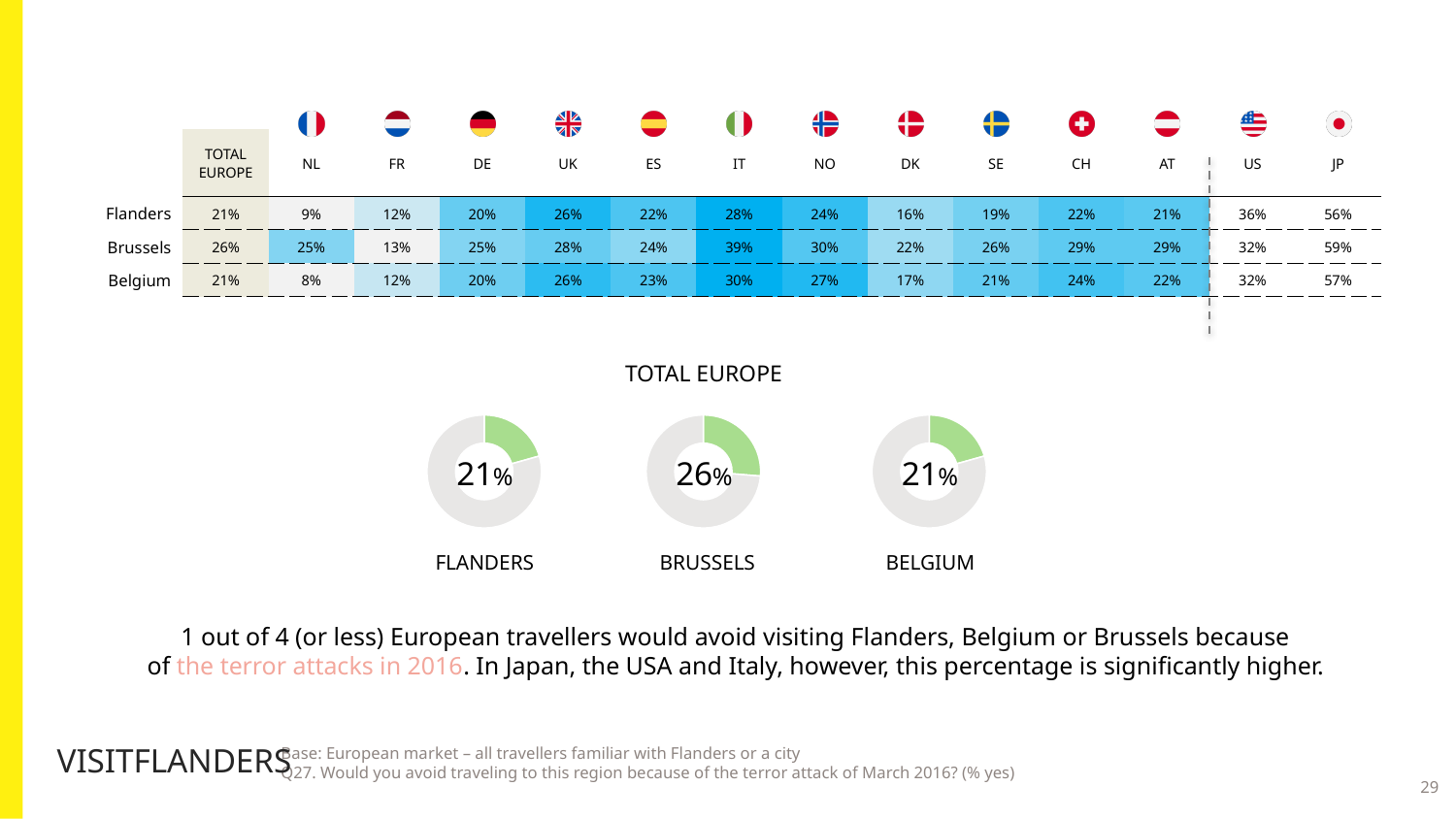
In the TOTAL EUROPE donut charts, is the value for Brussels larger or smaller than the value for Belgium? larger How many donut charts are shown under the TOTAL EUROPE heading? 3 In the table at the top of the slide, what percentage is shown for Flanders in the US column? 36% In the TOTAL EUROPE donut charts, what percentage is shown for Flanders? 21% In the TOTAL EUROPE donut charts, what is the difference between the Brussels and Flanders percentages? 5% In the TOTAL EUROPE donut charts, what percentage is shown for Belgium? 21% What type of chart is used to show the TOTAL EUROPE figures for Flanders, Brussels and Belgium? Donut (pie) chart In the table at the top of the slide, what percentage is shown for Brussels in the JP column? 59% In the table at the top of the slide, which country column has the highest value for Belgium? JP Among the three TOTAL EUROPE donut charts, which region has the highest percentage? Brussels What is the title above the three donut charts? TOTAL EUROPE In the TOTAL EUROPE donut charts, what percentage is shown for Brussels? 26%